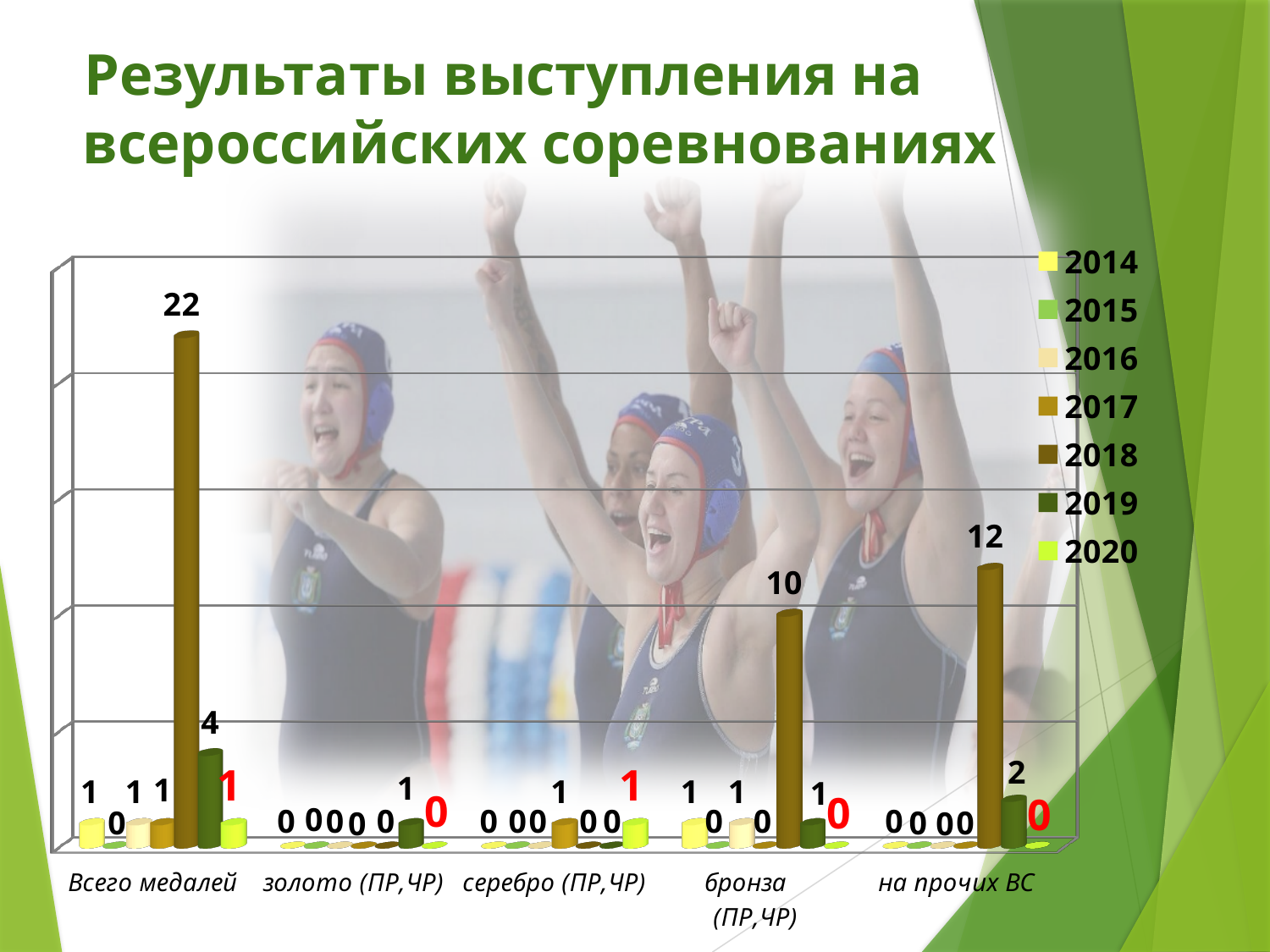
What is the value for 2018 in the 'бронза (ПР,ЧР)' category? 10 How many categories are shown on the x axis? 5 In which category does the 2018 series reach its highest value? Всего медалей What is the difference between the 2018 values for 'на прочих ВС' and 'бронза (ПР,ЧР)'? 2 What is the value for 2018 in the 'Всего медалей' category? 22 Which is larger in the 'Всего медалей' category: the value for 2018 or the value for 2019? 2018 What is the value for 2020 in the 'Всего медалей' category? 1 What is the value for 2019 in the 'Всего медалей' category? 4 How many series does the legend list? 7 What is the value for 2018 in the 'на прочих ВС' category? 12 What is the difference between the 2018 and 2019 values in the 'Всего медалей' category? 18 What is the value for 2019 in the 'на прочих ВС' category? 2